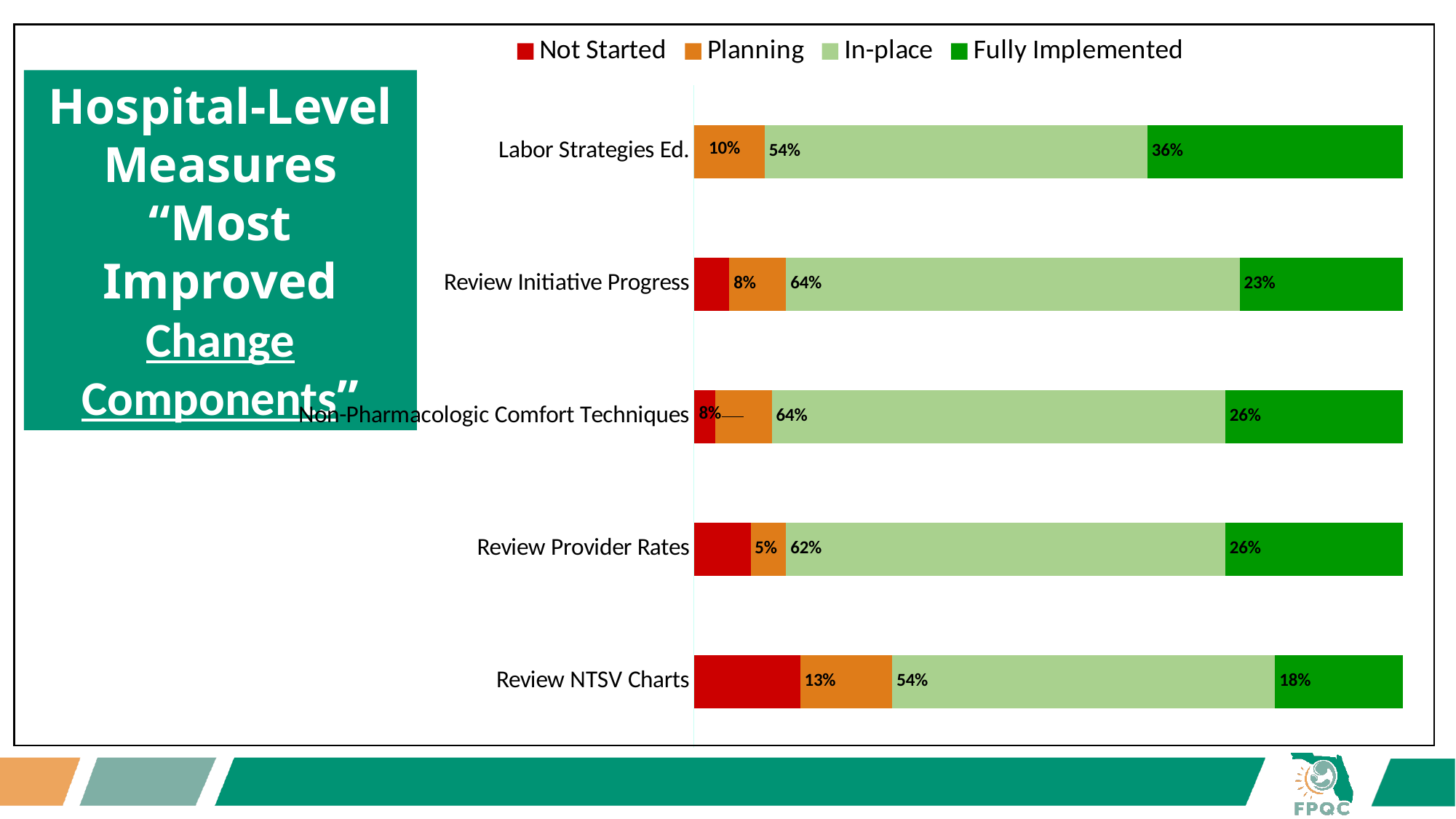
What is the Fully Implemented value for Review Provider Rates? 26% What is the In-place value for Review Initiative Progress? 64% What is the Planning value for Review NTSV Charts? 13% How many change components are shown on the chart? 5 What percentage of hospitals are Fully Implemented for Labor Strategies Ed.? 36% How many series does the legend list? 4 What kind of chart is shown on the slide? Stacked bar chart Which has a larger In-place percentage: Review Provider Rates or Labor Strategies Ed.? Review Provider Rates Which change component has the lowest Fully Implemented percentage? Review NTSV Charts Which change component has the lowest Planning percentage? Review Provider Rates Which change component has the highest Fully Implemented percentage? Labor Strategies Ed. What is the difference between the Fully Implemented percentages for Labor Strategies Ed. and Review NTSV Charts? 18 percentage points